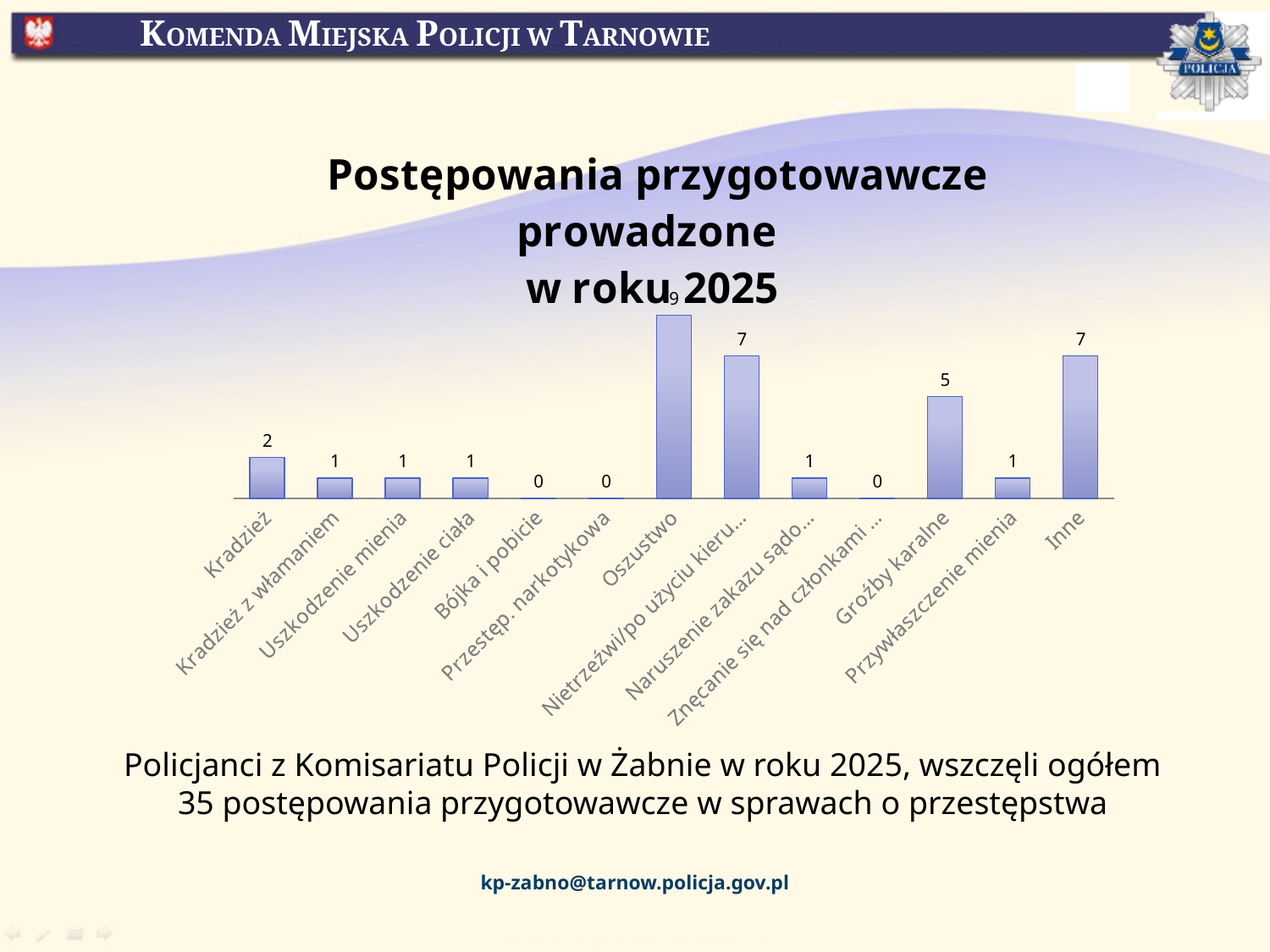
What is the value for Groźby karalne? 5 What is the value for Inne? 7 What kind of chart is shown on the slide? Bar chart Which category has the highest value? Oszustwo What is the difference between the values for Inne and Kradzież? 5 What is the value for Bójka i pobicie? 0 What is the value for Oszustwo? 9 How many categories are shown on the x axis? 13 What is the title of the chart? Postępowania przygotowawcze prowadzone w roku 2025 What is the difference between the values for Oszustwo and Groźby karalne? 4 What is the value for Kradzież? 2 Which is larger, the value for Groźby karalne or the value for Kradzież? Groźby karalne